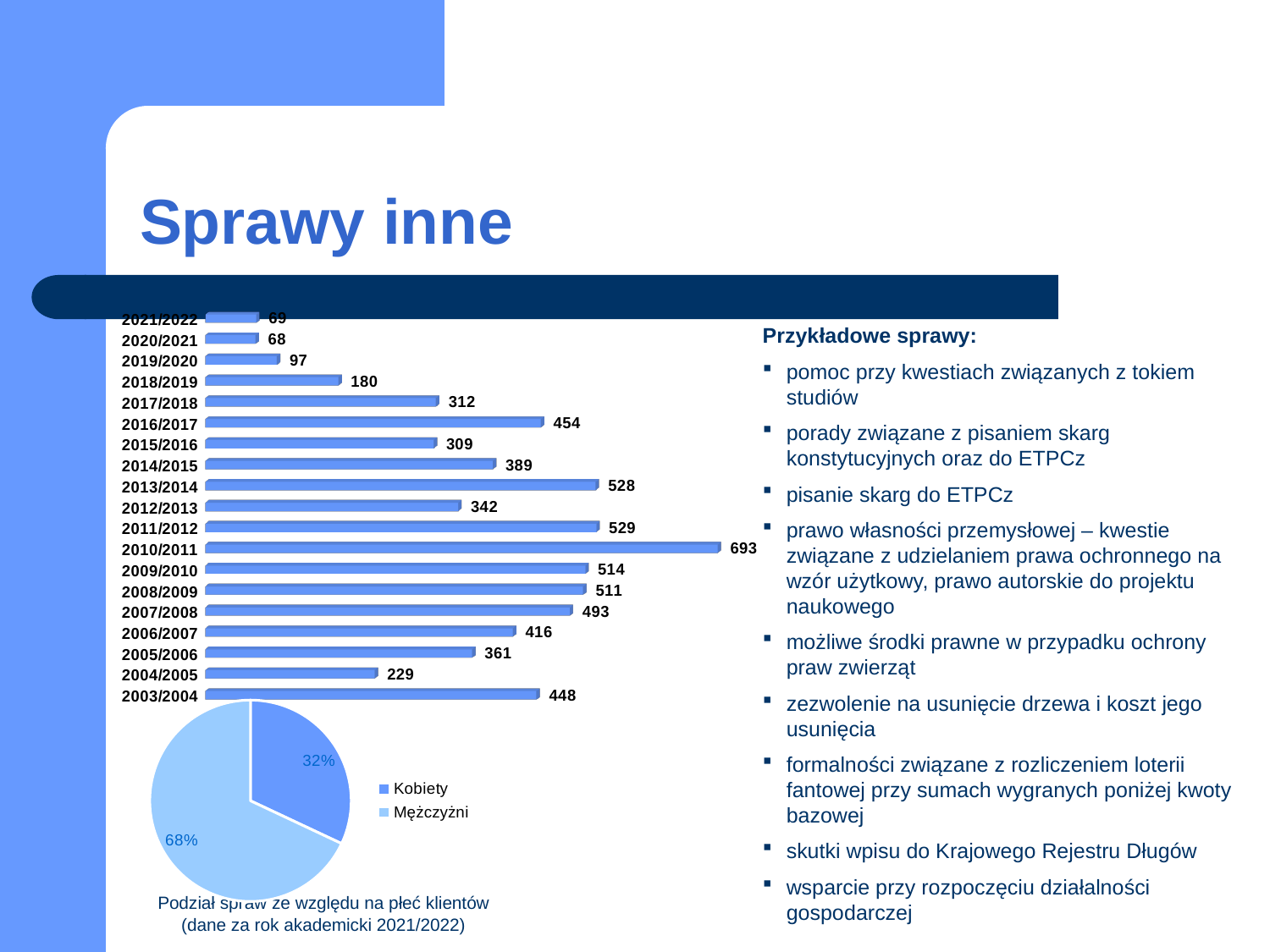
In the bar chart, what is the value for 2010/2011? 693 In the pie chart, which slice is larger, Kobiety or Mężczyźni? Mężczyźni How many entries does the legend of the pie chart list? 2 In the bar chart, what is the difference between the values for 2013/2014 and 2012/2013? 186 In the bar chart, what is the value for 2003/2004? 448 In the pie chart, what share is labelled for Kobiety? 32% In the bar chart, which is larger, the value for 2016/2017 or the value for 2015/2016? 2016/2017 In the bar chart, which academic year has the highest value? 2010/2011 In the bar chart, how many academic years are shown? 19 What kind of chart is the chart at the top left of the slide? bar chart In the bar chart, what is the value for 2018/2019? 180 In the bar chart, do the values rise or fall from 2017/2018 to 2021/2022? fall